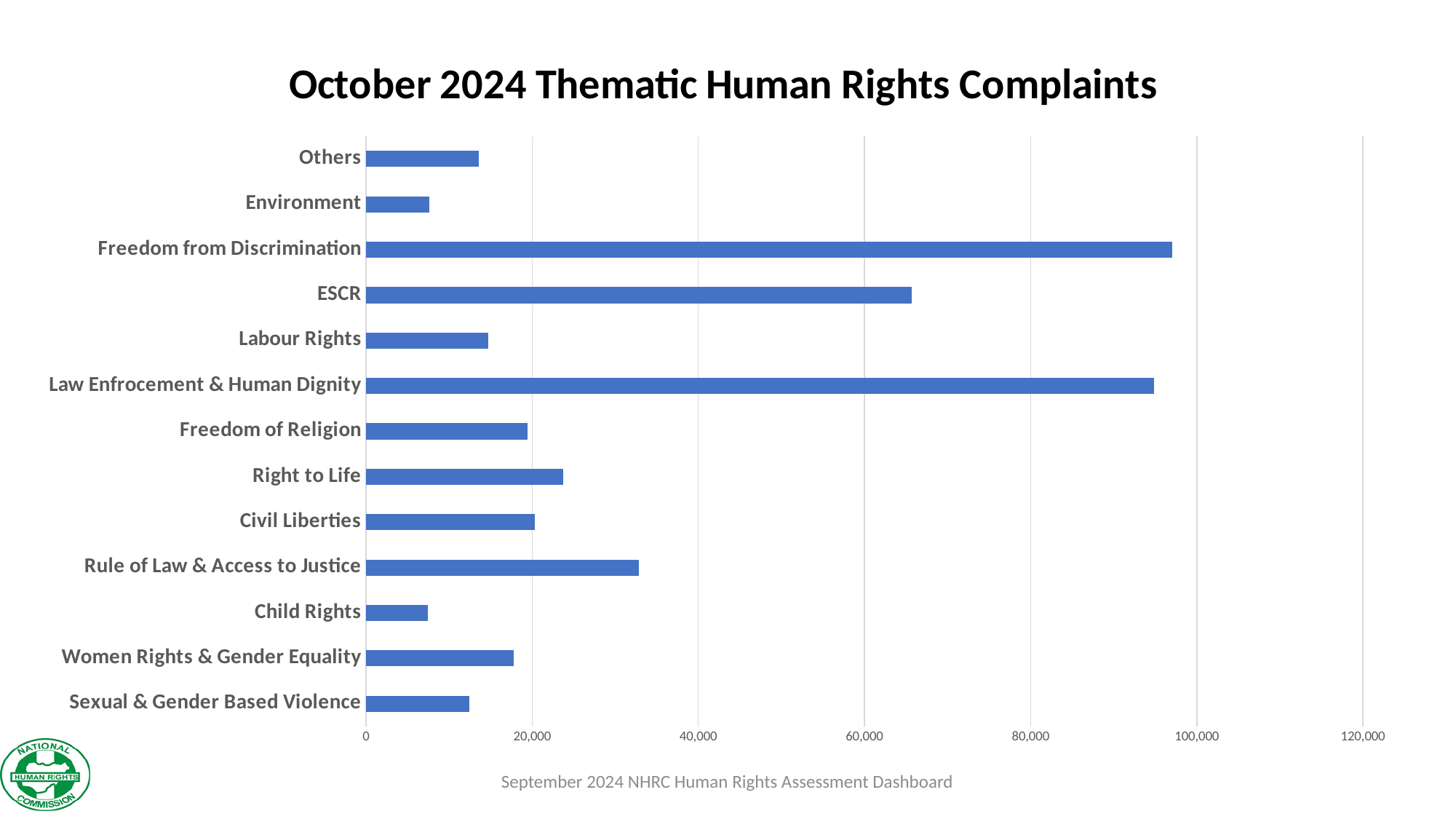
Is the value for Freedom from Discrimination greater or less than 80,000? greater Which is larger, the value for ESCR or the value for Rule of Law & Access to Justice? ESCR Which category has the highest number of complaints? Freedom from Discrimination Which is larger, the value for Right to Life or the value for Child Rights? Right to Life How many thematic categories are plotted in the chart? 13 What is the title of the chart? October 2024 Thematic Human Rights Complaints Which is larger, the value for Women Rights & Gender Equality or the value for Sexual & Gender Based Violence? Women Rights & Gender Equality Is the value for ESCR greater or less than 60,000? greater What kind of chart is shown on the slide? bar chart Is the value for Labour Rights greater or less than 20,000? less